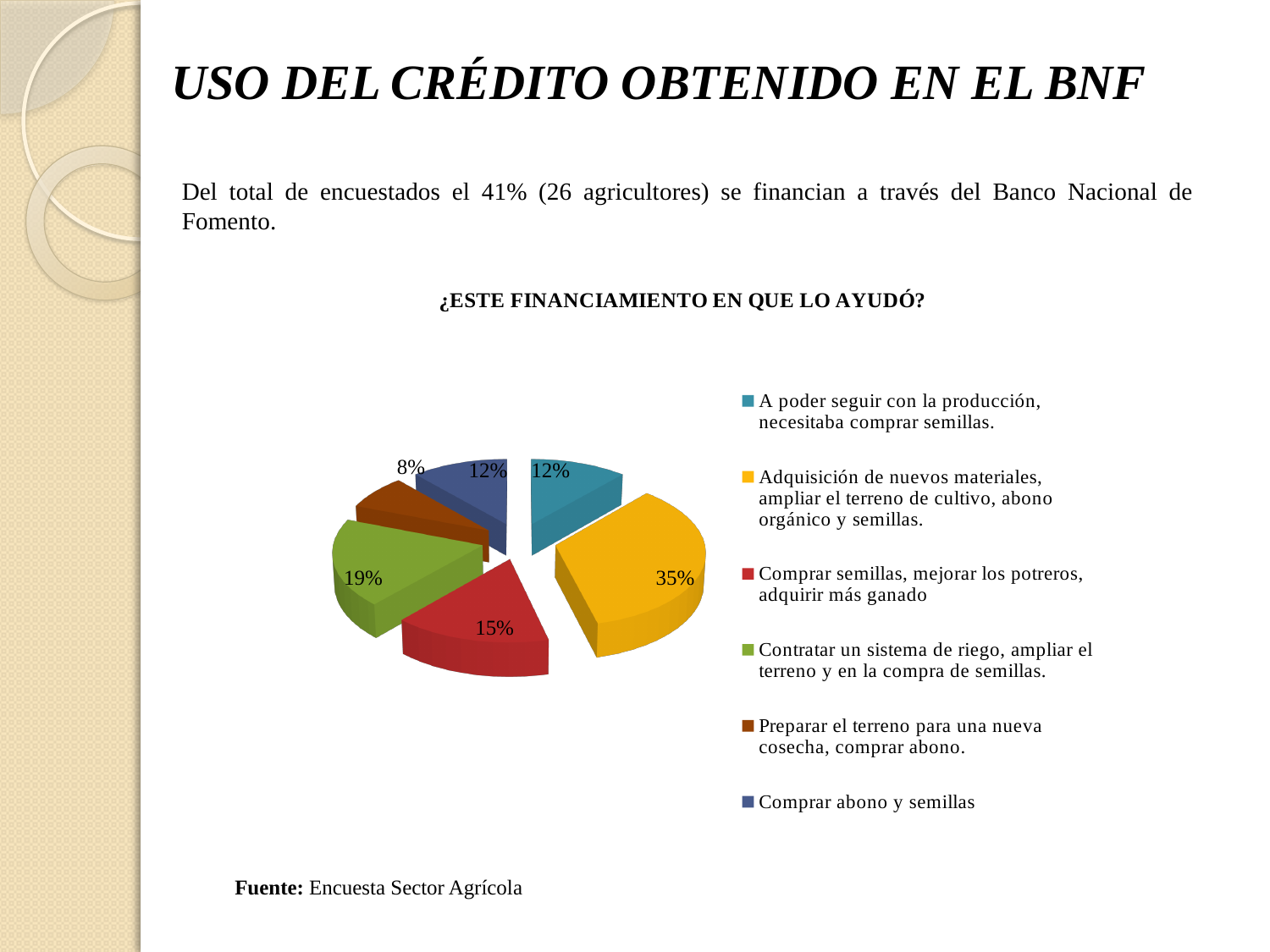
What share of the pie corresponds to 'Adquisición de nuevos materiales, ampliar el terreno de cultivo, abono orgánico y semillas'? 35% Which category has the smallest share of the pie? Preparar el terreno para una nueva cosecha, comprar abono Which is larger: the share for 'Comprar semillas, mejorar los potreros, adquirir más ganado' or the share for 'Comprar abono y semillas'? Comprar semillas, mejorar los potreros, adquirir más ganado What is the title of the chart? ¿ESTE FINANCIAMIENTO EN QUE LO AYUDÓ? Which category has the largest share of the pie? Adquisición de nuevos materiales, ampliar el terreno de cultivo, abono orgánico y semillas What share of the pie corresponds to 'Contratar un sistema de riego, ampliar el terreno y en la compra de semillas'? 19% What is the difference in percentage points between the largest slice (35%) and the 'Contratar un sistema de riego' slice (19%)? 16 What share of the pie corresponds to 'Comprar abono y semillas'? 12% What kind of chart is shown on the slide? pie chart How many slices does the pie chart have? 6